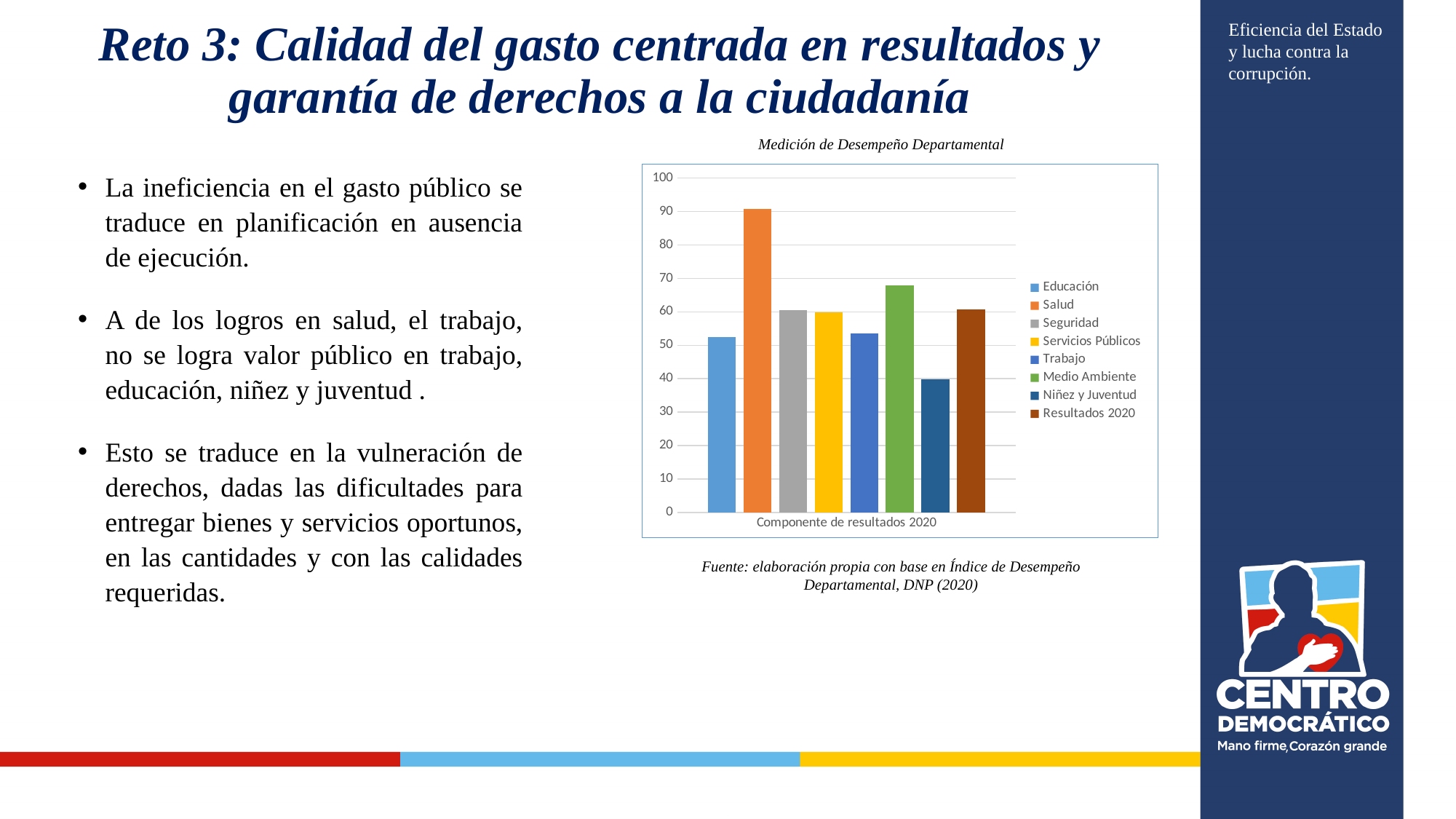
Is the value for Niñez y Juventud greater or less than 50? less Which is larger in the chart, the value for Medio Ambiente or the value for Trabajo? Medio Ambiente What kind of chart is shown on the slide? Bar chart Which series has the lowest bar in the chart? Niñez y Juventud Which is larger in the chart, the value for Salud or the value for Educación? Salud How many series does the legend of the chart list? 8 Which series has the highest bar in the chart? Salud Is the value for Medio Ambiente greater or less than 60? greater Is the value for Educación greater or less than 60? less What is the title of the chart? Medición de Desempeño Departamental What is the label shown on the x axis of the chart? Componente de resultados 2020